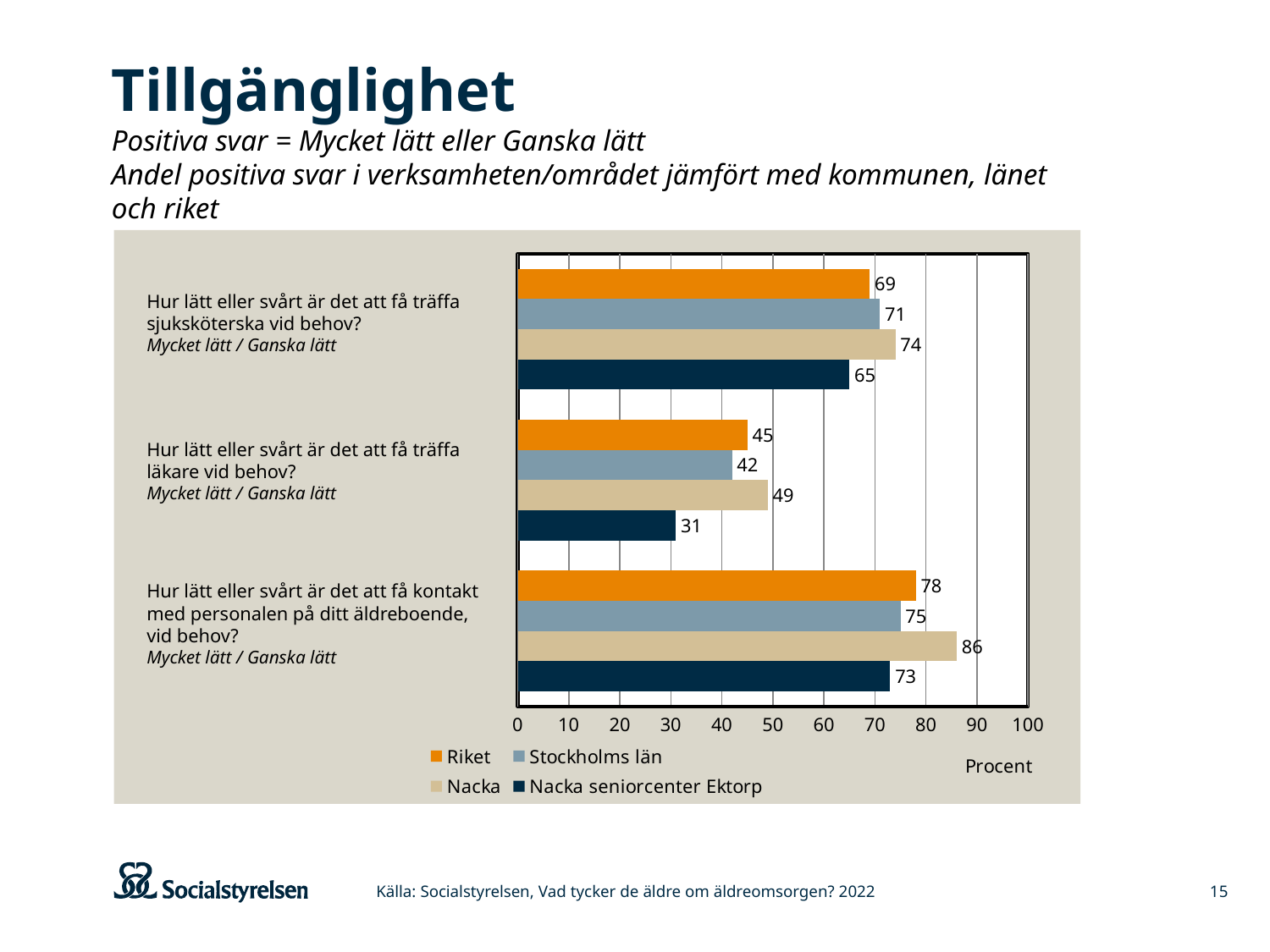
What is the difference between Stockholms län and Nacka seniorcenter Ektorp for the question about meeting a doctor (läkare) when needed? 11 What is the value for Riket for the question about meeting a doctor (läkare) when needed? 45 What type of chart is shown on the slide? bar chart How many questions (categories) are shown on the chart? 3 Which series has the lowest value for the question about getting in contact with staff at the elderly home? Nacka seniorcenter Ektorp What is the difference between Nacka and Nacka seniorcenter Ektorp for the question about getting in contact with staff at the elderly home? 13 How many series does the legend list? 4 What is the value for Nacka for the question about getting in contact with staff at the elderly home? 86 Which series has the highest value for the question about meeting a doctor (läkare) when needed? Nacka What label is shown on the horizontal axis of the chart? Procent Which is larger for the question about meeting a nurse (sjuksköterska): Riket or Stockholms län? Stockholms län What is the value for Nacka seniorcenter Ektorp for the question about meeting a nurse (sjuksköterska) when needed? 65